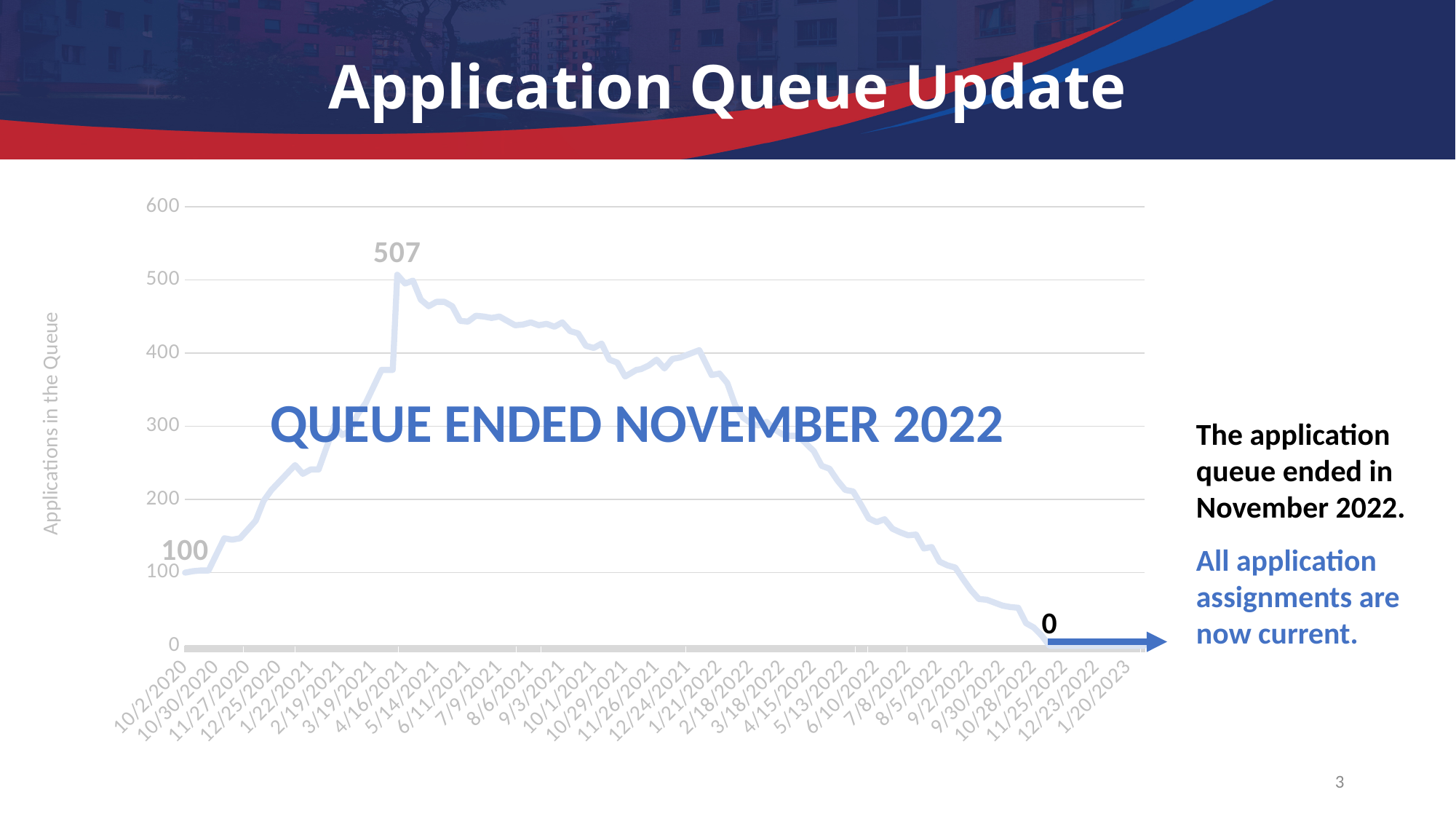
What is the final labelled value at the end of the line? 0 What is the lowest labelled value on the chart? 0 How does the line move after reaching its peak in 2021? it falls to 0 Is the value at 9/30/2022 greater or less than 100? less What kind of chart is shown on the slide? line chart What is the value labelled at the start of the line, at 10/2/2020? 100 Is the value at 1/22/2021 greater or less than 200? greater Which is larger, the starting value at 10/2/2020 or the peak value? the peak value (507) What is the difference between the peak value and the starting value of 100? 407 What is the label on the vertical axis of the chart? Applications in the Queue What is the peak value shown on the chart? 507 Is the value at 9/3/2021 greater or less than 400? greater